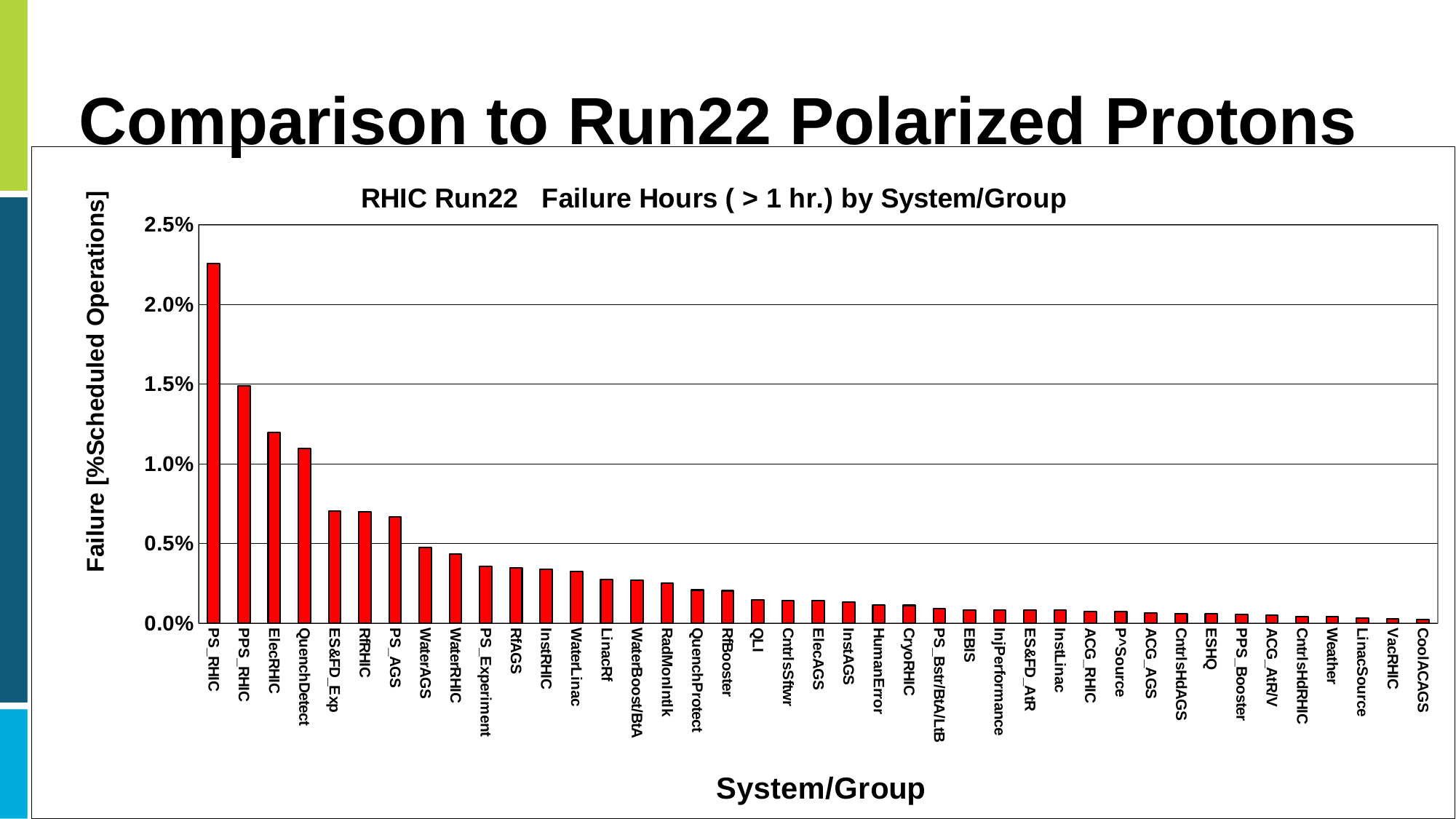
What is the title of the chart? RHIC Run22 Failure Hours ( > 1 hr.) by System/Group Is the value for ES&FD_Exp greater or less than 0.5%? greater Is the value for PS_RHIC greater or less than 2.0%? greater Which has a higher failure percentage, PPS_RHIC or ElecRHIC? PPS_RHIC What is the label of the vertical axis? Failure [%Scheduled Operations] Which system/group has the highest failure percentage? PS_RHIC Is the value for ElecRHIC greater or less than 1.0%? greater Which system/group has the lowest failure percentage? CoolACAGS What type of chart is shown on the slide? bar chart Do the values rise or fall moving from left to right along the x axis? fall Which has a higher failure percentage, LinacRf or QLI? LinacRf